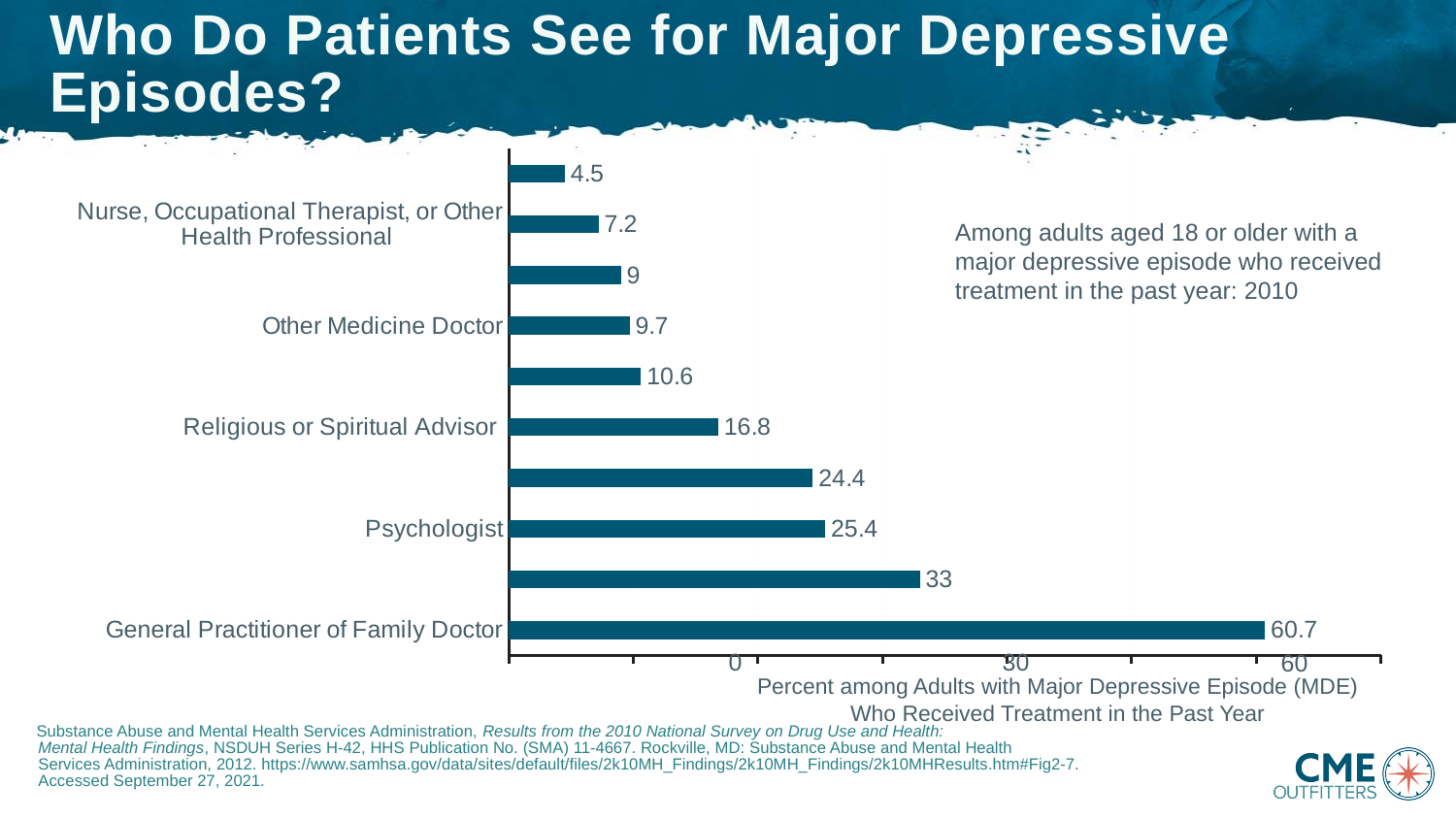
What is the difference between the values for General Practitioner of Family Doctor and Psychologist? 35.3 Which is larger, the value for Religious or Spiritual Advisor or the value for Other Medicine Doctor? Religious or Spiritual Advisor How many bars are plotted in the chart? 10 Is the value for Psychologist greater or less than 30? less Which labeled category has the highest value? General Practitioner of Family Doctor What is the value for Psychologist? 25.4 What is the smallest value shown on any bar in the chart? 4.5 What is the value for Religious or Spiritual Advisor? 16.8 What is the value for Other Medicine Doctor? 9.7 What is the value for Nurse, Occupational Therapist, or Other Health Professional? 7.2 What is the value for General Practitioner of Family Doctor? 60.7 What kind of chart is shown on the slide? Bar chart